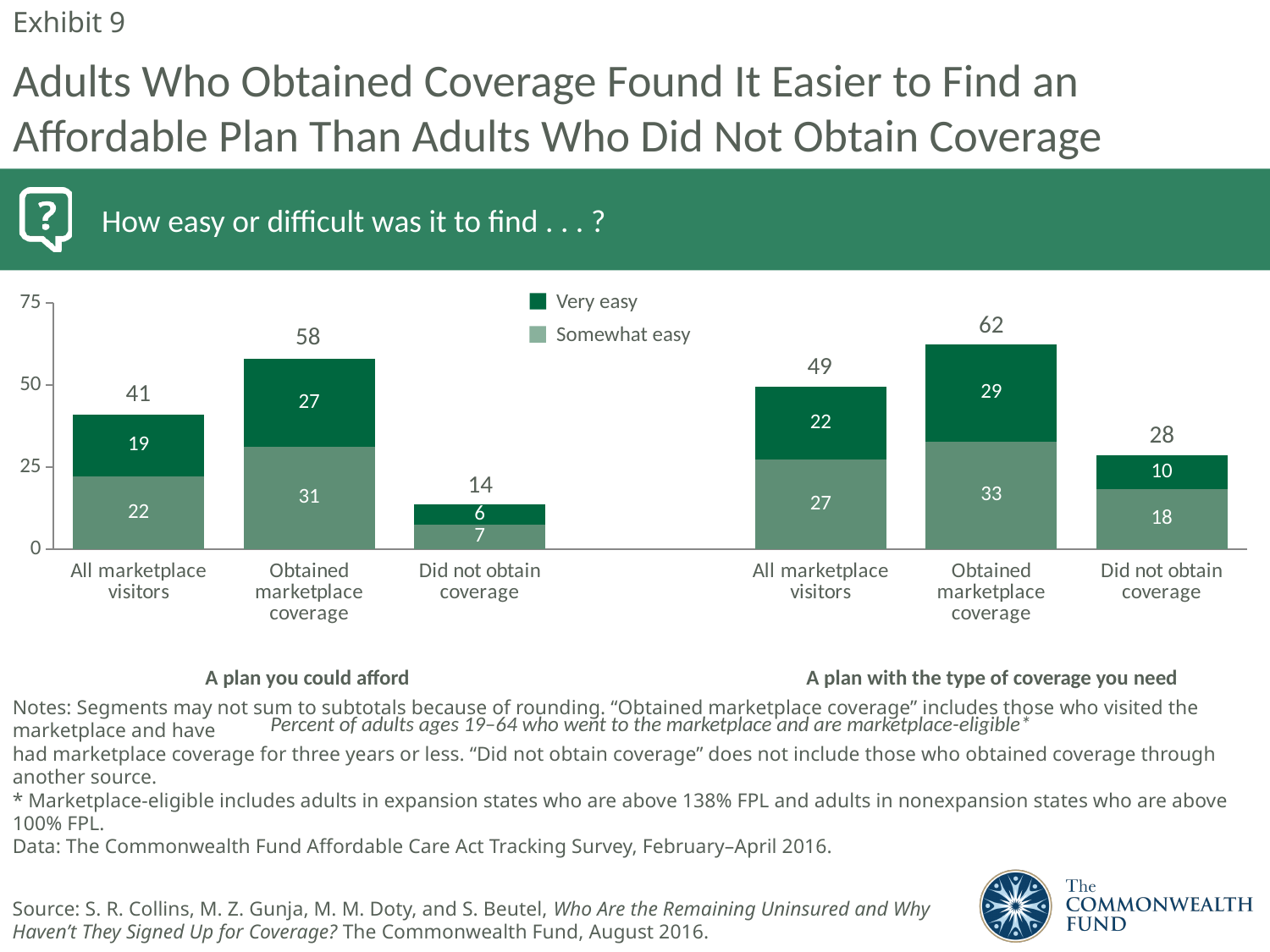
What is the difference between the totals for 'Obtained marketplace coverage' and 'Did not obtain coverage' in the 'A plan you could afford' group? 44 How many series does the legend list? 2 What question is posed in the green banner above the chart? How easy or difficult was it to find . . . ? In the 'A plan you could afford' group, what is the 'Somewhat easy' value for 'Did not obtain coverage'? 7 In the 'A plan you could afford' group, what is the total for 'Obtained marketplace coverage'? 58 Which is larger: the total for 'All marketplace visitors' in the 'A plan you could afford' group or in the 'A plan with the type of coverage you need' group? A plan with the type of coverage you need In the 'A plan with the type of coverage you need' group, what is the 'Very easy' value for 'All marketplace visitors'? 22 What kind of chart is shown on the slide? Stacked bar chart In the 'A plan with the type of coverage you need' group, which category has the highest total? Obtained marketplace coverage In the 'A plan you could afford' group, which category has the lowest total? Did not obtain coverage How many bars are plotted in the chart in total? 6 Is the total for 'Did not obtain coverage' in the 'A plan with the type of coverage you need' group greater or less than 25? greater